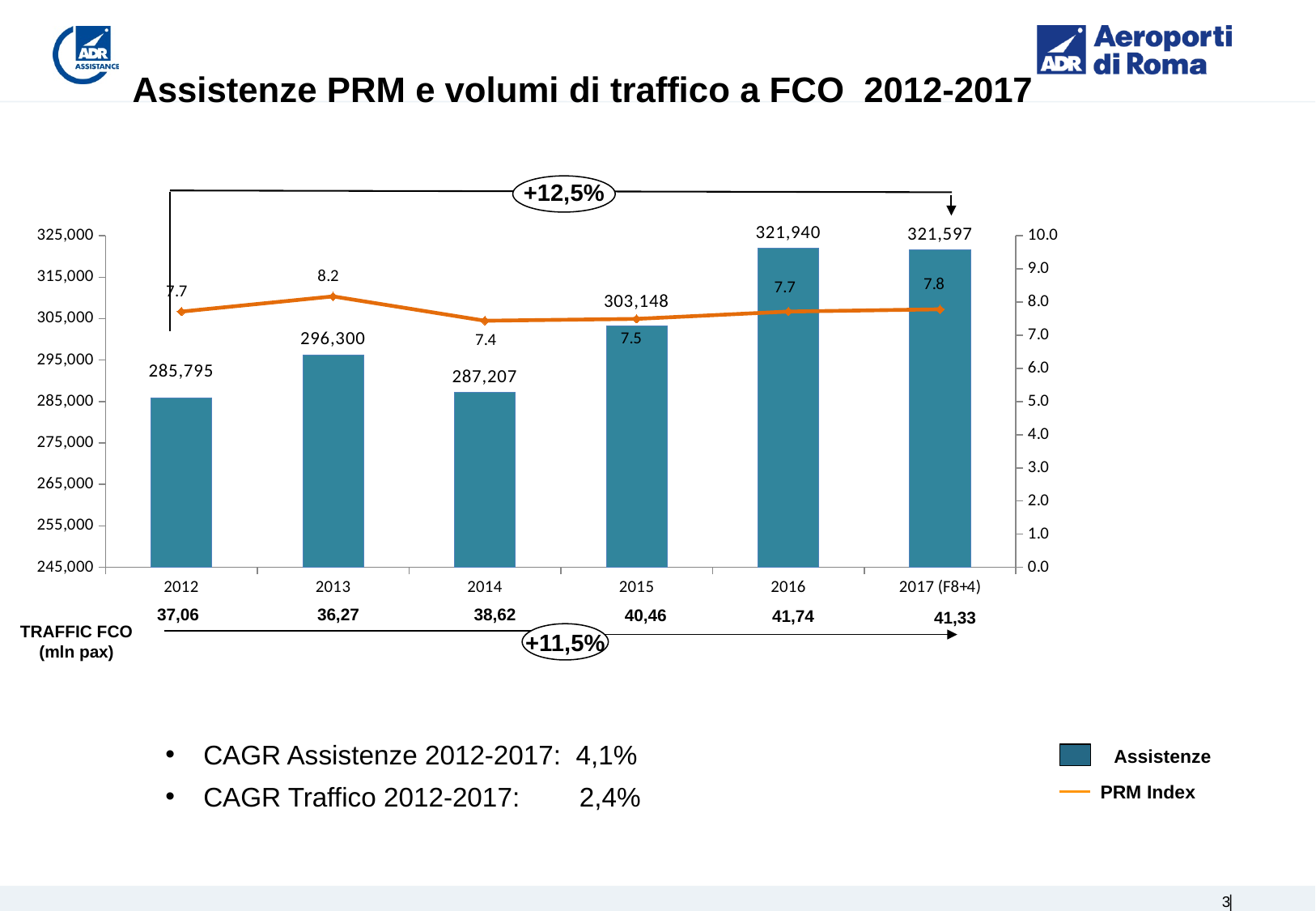
What is the CAGR Assistenze 2012-2017 stated on the slide? 4,1% What is the Assistenze value for 2012? 285,795 Which is larger, the Assistenze value for 2013 or for 2014? 2013 What is the Assistenze value for 2015? 303,148 Which year has the highest Assistenze value? 2016 What kind of chart is used for the Assistenze series? Bar chart What is the PRM Index value for 2013? 8.2 How many years are shown on the x axis? 6 How many series does the legend list? 2 What is the difference between the Assistenze values for 2016 and 2012? 36,145 What is the PRM Index value for 2017 (F8+4)? 7.8 Which year has the lowest PRM Index value? 2014